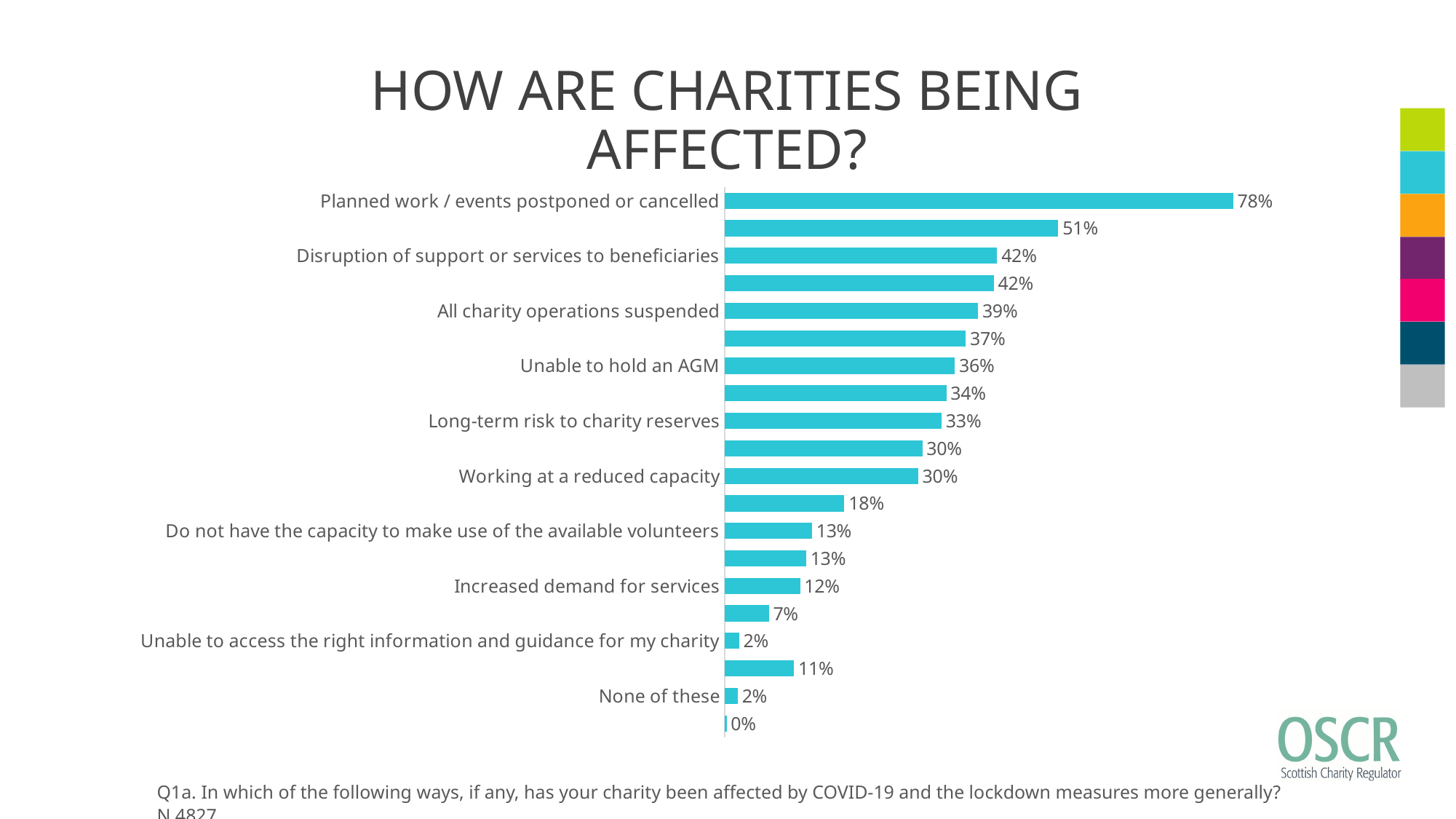
What kind of chart is shown on the slide? Bar chart What is the value for 'Disruption of support or services to beneficiaries'? 42% Which category has the highest value? Planned work / events postponed or cancelled What is the title of the slide? HOW ARE CHARITIES BEING AFFECTED? What is the value for 'Increased demand for services'? 12% What is the value for 'None of these'? 2% What is the value for 'Unable to hold an AGM'? 36% How many bars are plotted on the chart? 20 What is the value for 'Planned work / events postponed or cancelled'? 78% What is the difference between 'Planned work / events postponed or cancelled' and 'Disruption of support or services to beneficiaries'? 36 percentage points Which is larger: 'All charity operations suspended' or 'Working at a reduced capacity'? All charity operations suspended What is the smallest value shown on the chart? 0%